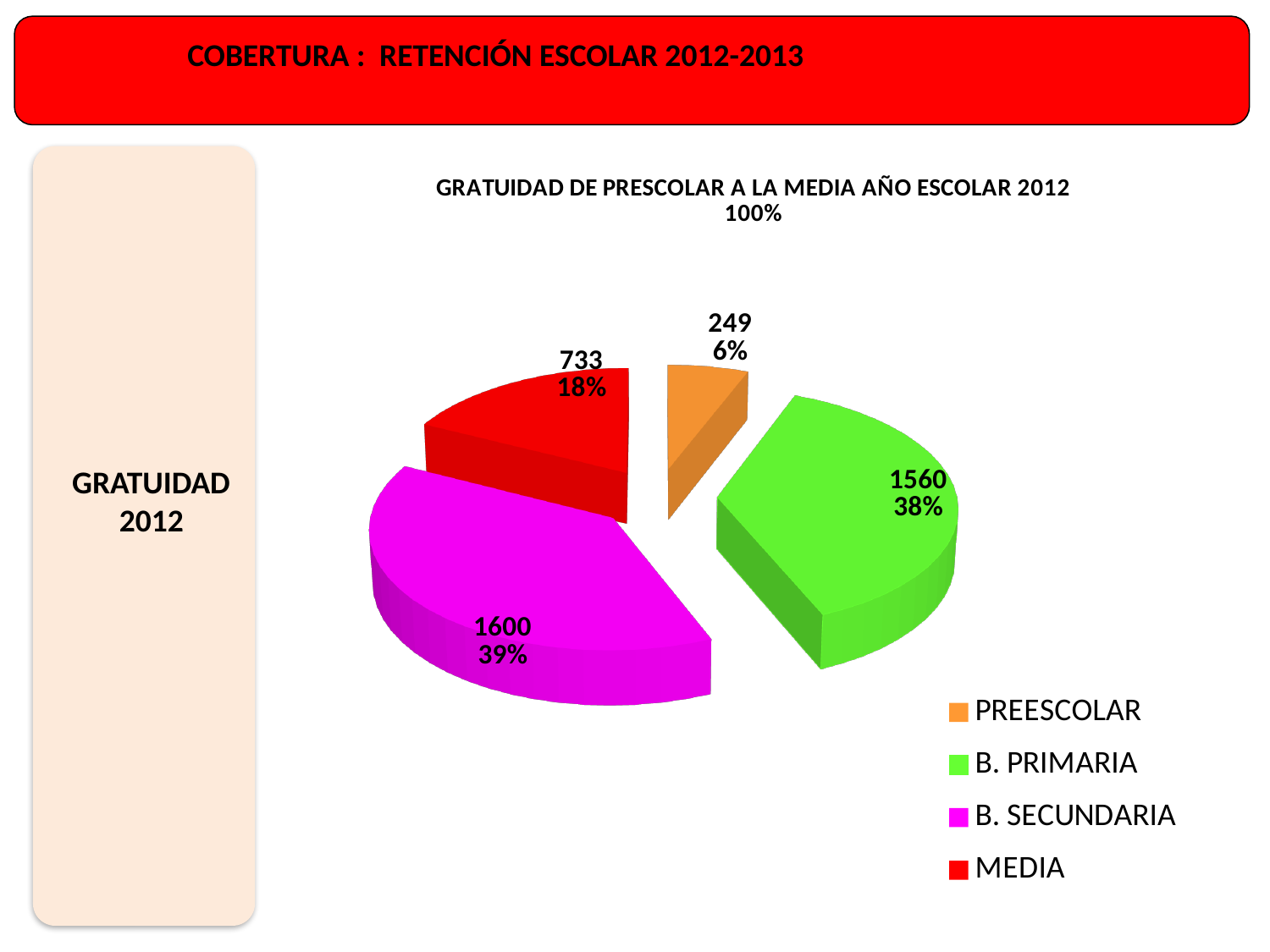
Which is larger, the value for B. PRIMARIA or the value for MEDIA? B. PRIMARIA Which category has the largest slice? B. SECUNDARIA How many categories does the pie chart have? 4 What type of chart is shown on the slide? Pie chart What is the value for B. PRIMARIA? 1560 What is the value for MEDIA? 733 What percentage share does B. SECUNDARIA have? 39% What is the title of the chart? GRATUIDAD DE PRESCOLAR A LA MEDIA AÑO ESCOLAR 2012 100% What is the value for PREESCOLAR? 249 What percentage share does MEDIA have? 18% Which category has the smallest slice? PREESCOLAR What is the difference between the values for MEDIA and PREESCOLAR? 484